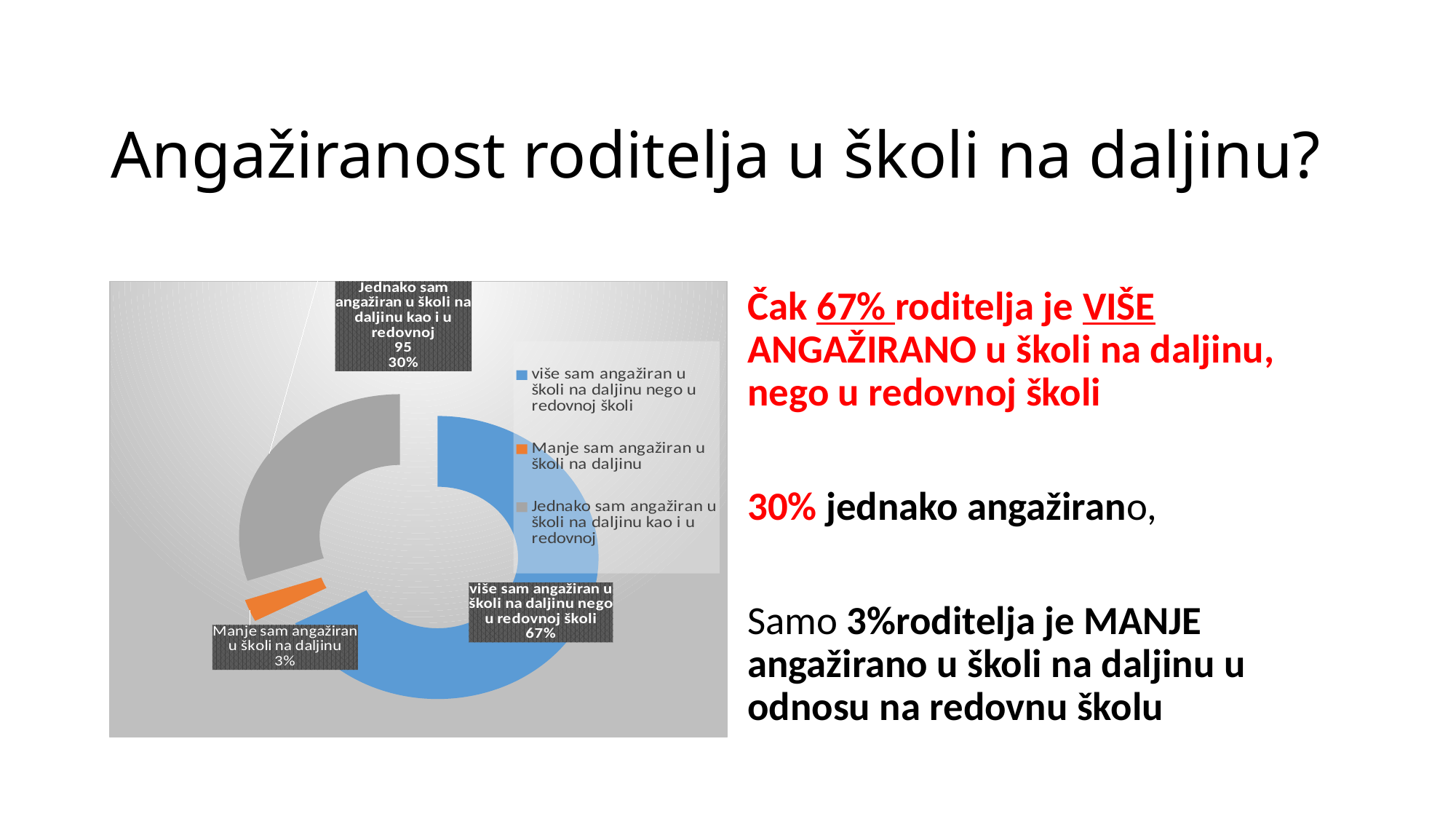
Which slice is larger: "Jednako sam angažiran u školi na daljinu kao i u redovnoj" or "Manje sam angažiran u školi na daljinu"? Jednako sam angažiran u školi na daljinu kao i u redovnoj What colour is the slice for "Manje sam angažiran u školi na daljinu" in the chart? Orange Which category has the smallest slice of the doughnut chart? Manje sam angažiran u školi na daljinu How many entries does the chart legend list? 3 What percentage share is shown for the slice "više sam angažiran u školi na daljinu nego u redovnoj školi"? 67% What kind of chart is shown on the slide? Doughnut (pie) chart What is the difference in percentage points between the "više sam angažiran" slice (67%) and the "Jednako sam angažiran" slice (30%)? 37 percentage points What count value is printed on the data label for "Jednako sam angažiran u školi na daljinu kao i u redovnoj"? 95 What percentage share is shown for the slice "Manje sam angažiran u školi na daljinu"? 3% What percentage share is shown for the slice "Jednako sam angažiran u školi na daljinu kao i u redovnoj"? 30% How many categories (slices) does the doughnut chart have? 3 Which category has the largest slice of the doughnut chart? više sam angažiran u školi na daljinu nego u redovnoj školi